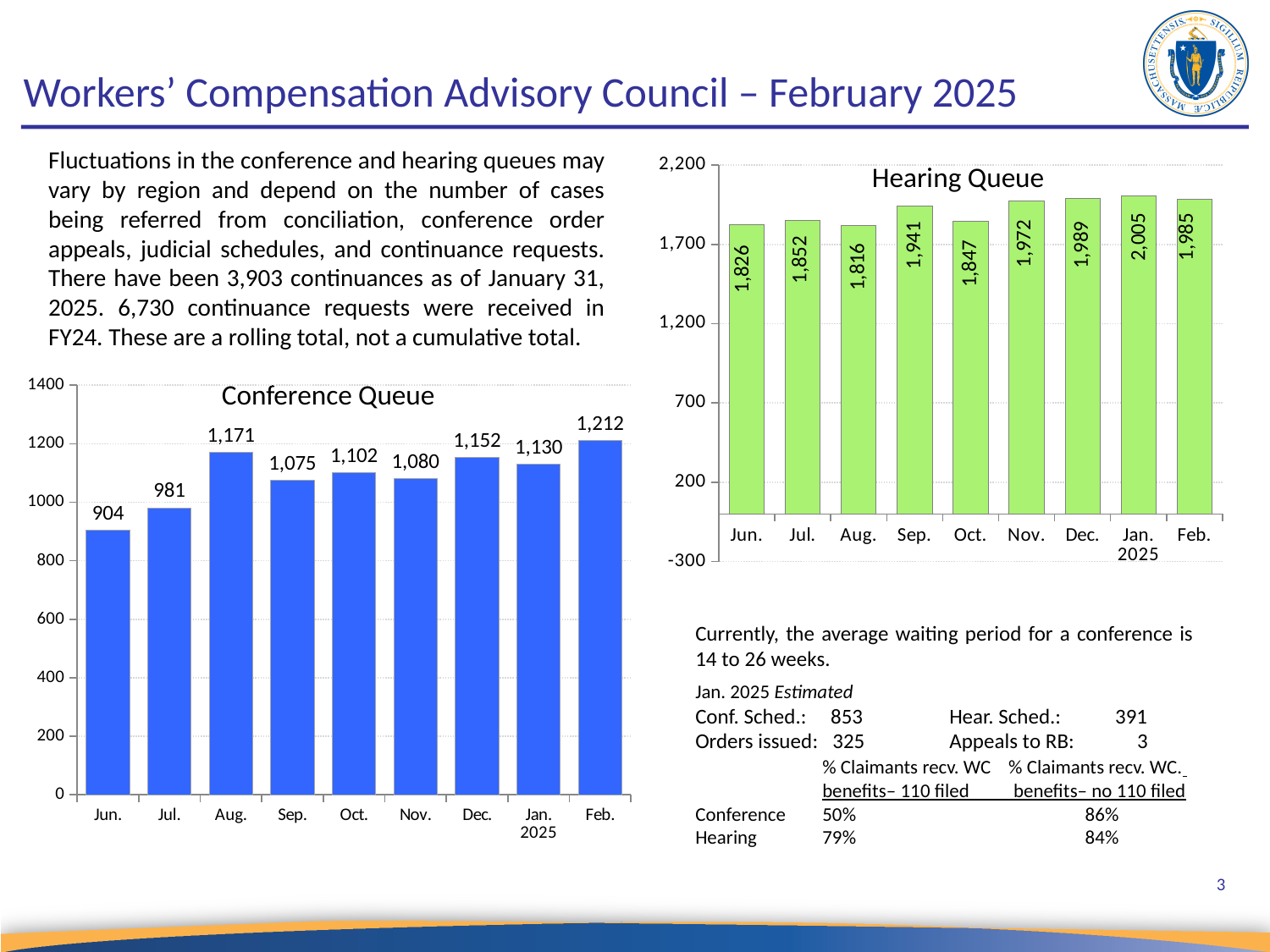
In the Hearing Queue chart, which month has the highest value? Jan. 2025 In the Conference Queue chart, what is the difference between the values for Feb. and Jan. 2025? 82 In the Hearing Queue chart, what is the difference between the values for Jan. 2025 and Jun.? 179 In the Conference Queue chart, which month has the highest value? Feb. In the Conference Queue chart, what is the value for Jun.? 904 In the Conference Queue chart, which month has the lowest value? Jun. In the Hearing Queue chart, which month has the lowest value? Aug. In the Hearing Queue chart, what is the value for Sep.? 1,941 What colour are the bars in the Hearing Queue chart? Green What type of chart is the Conference Queue chart? Bar chart In the Conference Queue chart, which is larger, the value for Aug. or the value for Dec.? Aug. How many months are plotted in the Hearing Queue chart? 9